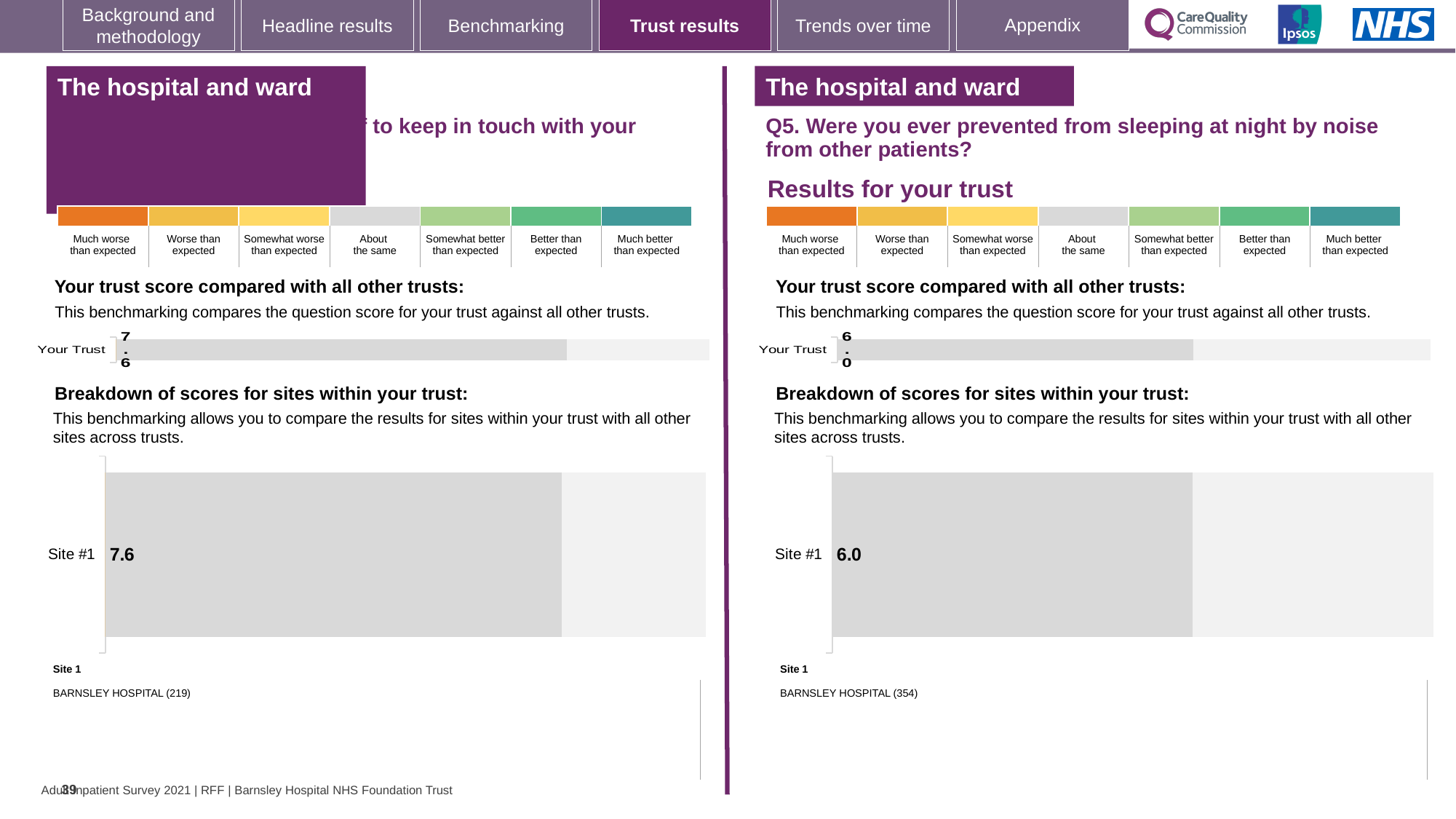
Which site name is listed as Site 1 beneath the right-hand (Q5) breakdown chart? BARNSLEY HOSPITAL (354) On the right-hand side of the slide (Q5), what score is shown for 'Your Trust' in the 'Your trust score compared with all other trusts' chart? 6.0 What type of chart is used in the right-hand (Q5) 'Breakdown of scores for sites within your trust' section? Bar chart Which site name is listed as Site 1 beneath the left-hand breakdown chart? BARNSLEY HOSPITAL (219) How many sites are shown in the right-hand (Q5) 'Breakdown of scores for sites within your trust' chart? 1 On the right-hand side of the slide (Q5), what is the score shown for Site #1 in the 'Breakdown of scores for sites within your trust' chart? 6.0 Is the Site #1 score in the right-hand (Q5) breakdown chart greater or less than the Site #1 score in the left-hand breakdown chart? less What is the difference between the Site #1 score in the left-hand breakdown chart (7.6) and the Site #1 score in the right-hand Q5 breakdown chart (6.0)? 1.6 Which is larger: the Site #1 score in the left-hand breakdown chart or the Site #1 score in the right-hand (Q5) breakdown chart? The left-hand chart (7.6) On the left-hand side of the slide, what score is shown for 'Your Trust' in the 'Your trust score compared with all other trusts' chart? 7.6 On the left-hand side of the slide, what is the score shown for Site #1 in the 'Breakdown of scores for sites within your trust' chart? 7.6 How many sites are shown in the left-hand 'Breakdown of scores for sites within your trust' chart? 1